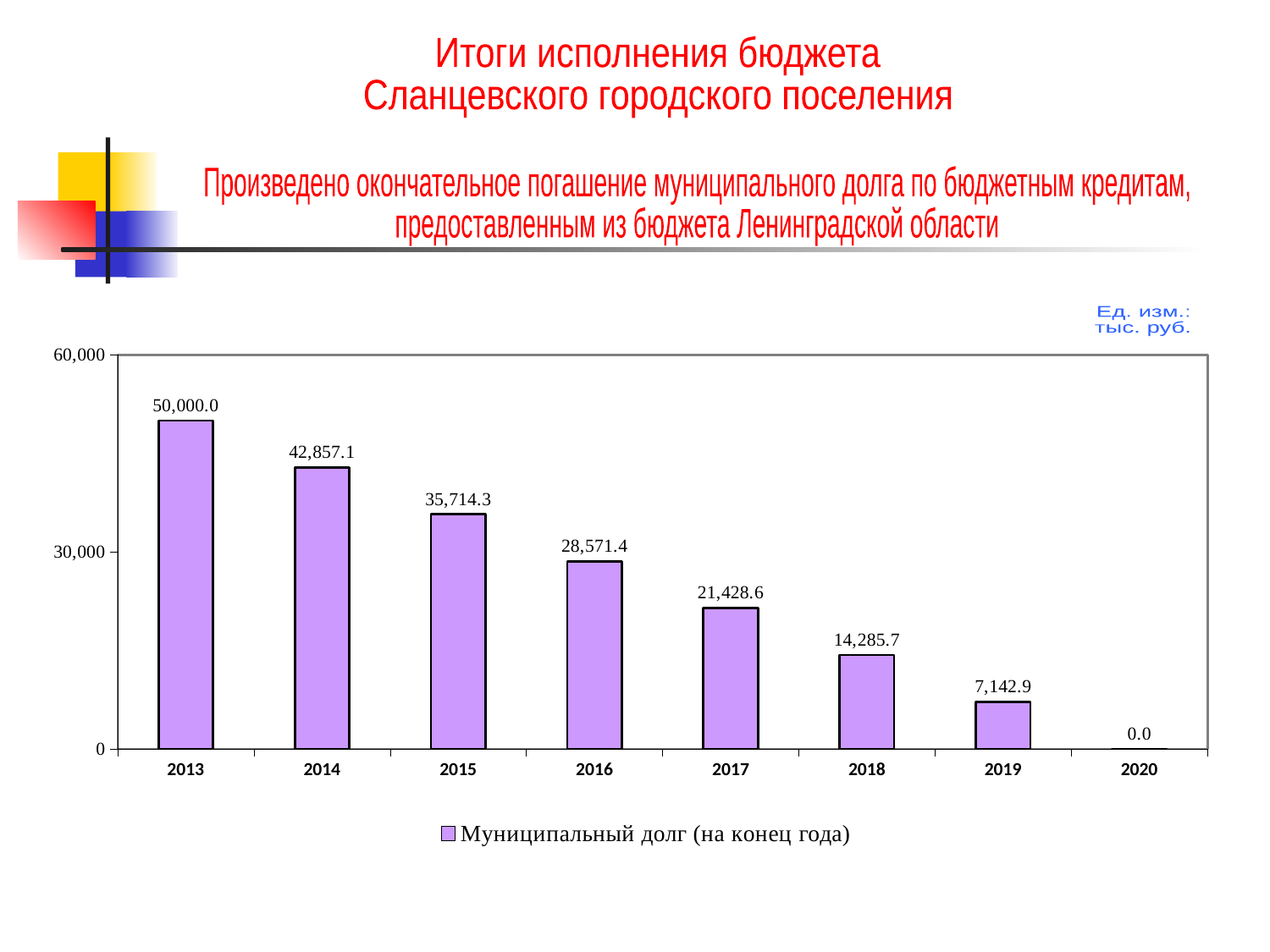
Which year has the highest municipal debt? 2013 What is the value of municipal debt at the end of 2020? 0.0 What is the value of municipal debt at the end of 2017? 21,428.6 How many years are shown on the x axis? 8 What is the difference between the municipal debt in 2013 and in 2014? 7,142.9 What is the value of municipal debt at the end of 2013? 50,000.0 What kind of chart is shown on the slide? bar chart Which is larger, the municipal debt in 2016 or in 2018? 2016 Is the value for 2015 greater or less than 30,000? greater How many series does the legend list? 1 Which year has the lowest municipal debt? 2020 Do the values rise or fall from 2013 to 2020? fall